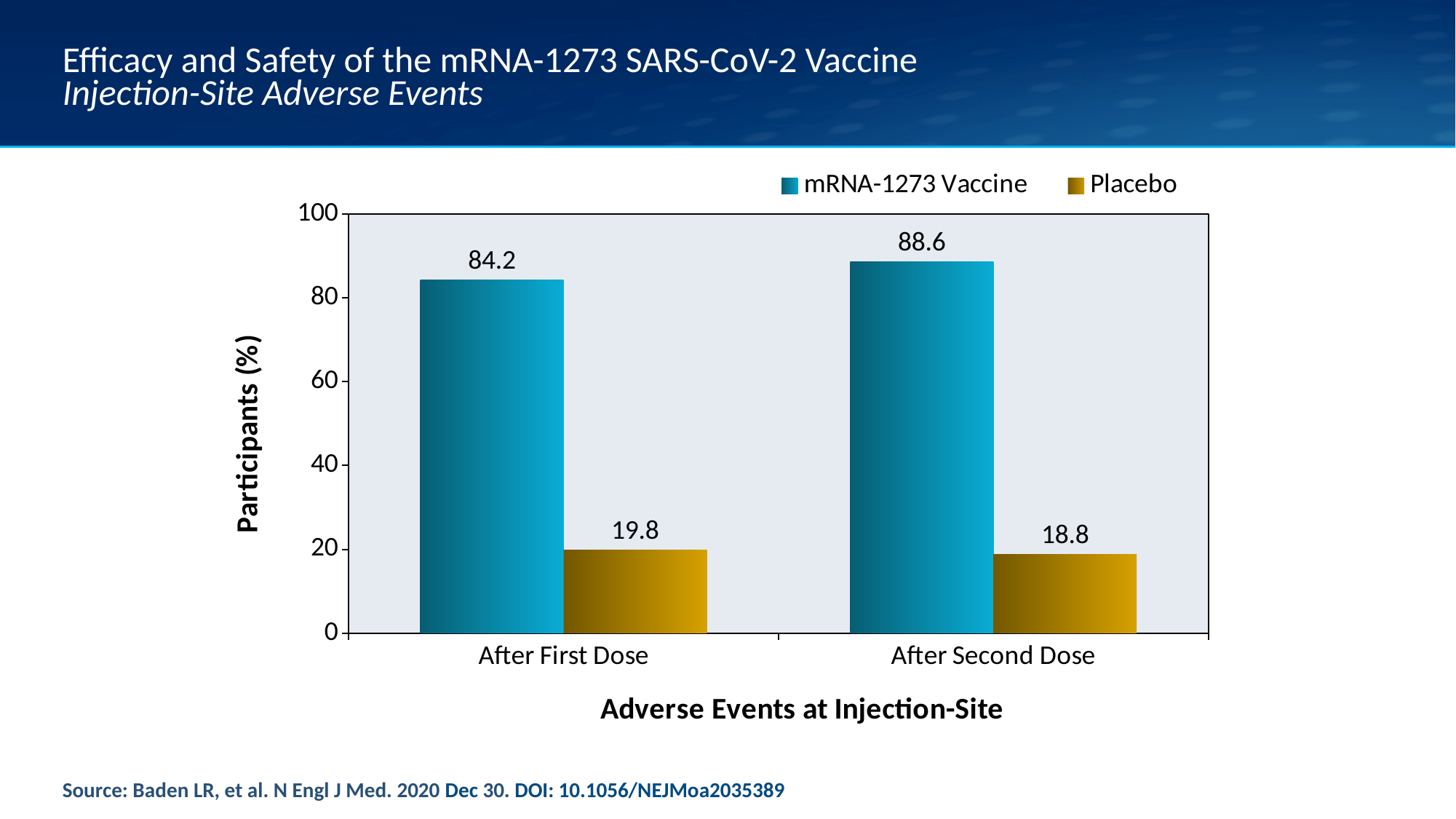
What percentage of participants in the mRNA-1273 Vaccine group had injection-site adverse events after the first dose? 84.2 How many series does the legend list? 2 Which is larger: the Placebo value after the first dose or after the second dose? After First Dose What is the difference between the mRNA-1273 Vaccine values after the second dose and after the first dose? 4.4 What is the label of the y axis? Participants (%) Which bar has the highest value on the chart? mRNA-1273 Vaccine, After Second Dose What is the value for the Placebo group after the first dose? 19.8 What kind of chart is shown on the slide? Bar chart What is the difference between the mRNA-1273 Vaccine and Placebo values after the first dose? 64.4 What percentage of participants in the Placebo group had injection-site adverse events after the second dose? 18.8 What is the value for the mRNA-1273 Vaccine group after the second dose? 88.6 Which bar has the lowest value on the chart? Placebo, After Second Dose